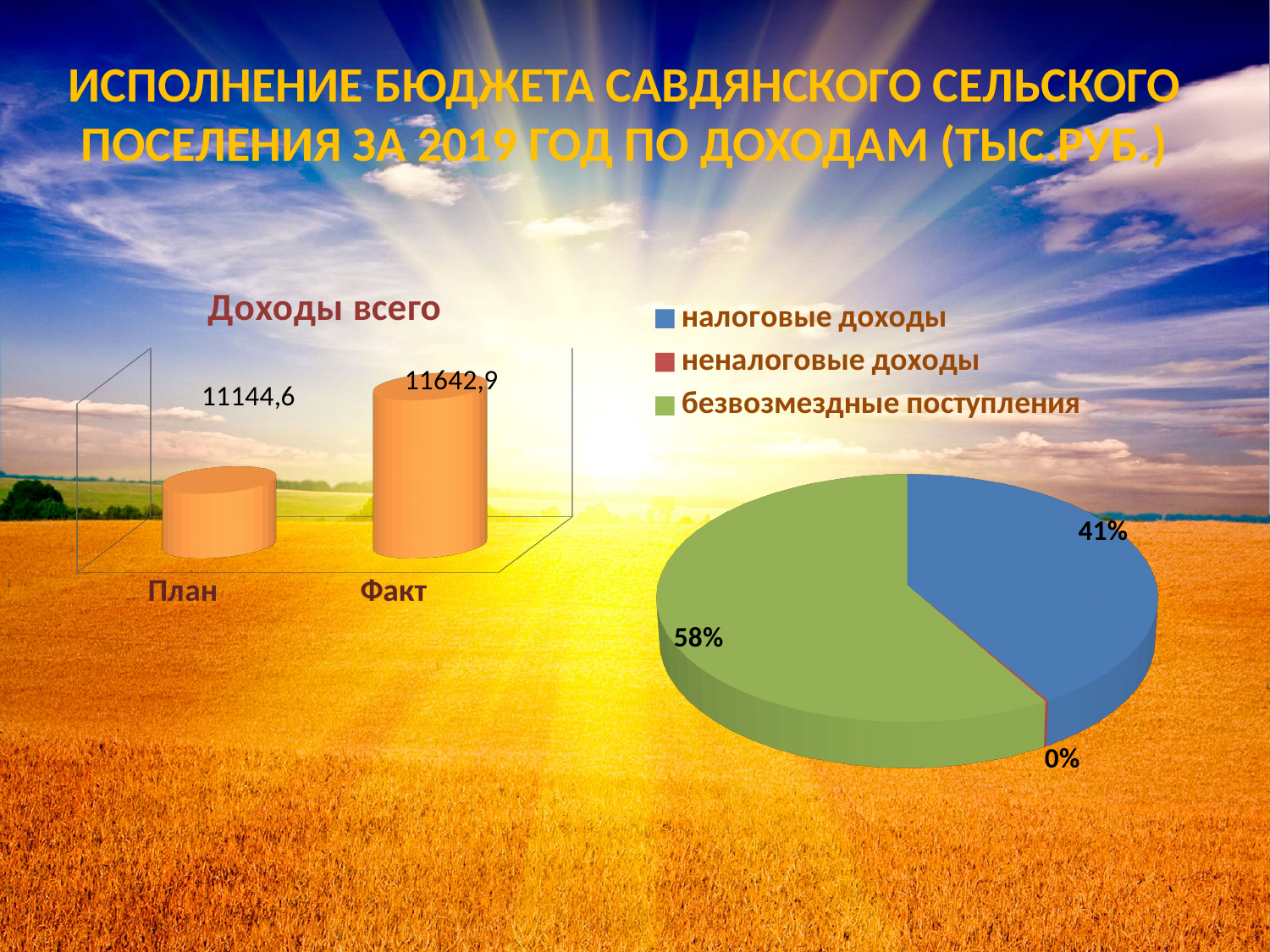
In the 'Доходы всего' chart, what is the value for Факт? 11642,9 In the pie chart on the right, which category has the largest share? безвозмездные поступления In the pie chart on the right, what share is labelled for безвозмездные поступления? 58% In the pie chart on the right, how many entries does the legend list? 3 In the pie chart on the right, what share is labelled for неналоговые доходы? 0% In the pie chart on the right, what colour is the slice for налоговые доходы? Blue In the 'Доходы всего' chart, what is the value for План? 11144,6 In the 'Доходы всего' chart, what is the difference between Факт and План? 498,3 In the pie chart on the right, what share is labelled for налоговые доходы? 41% In the 'Доходы всего' chart, which category has the higher value, План or Факт? Факт What kind of chart is the 'Доходы всего' chart? Bar chart In the 'Доходы всего' chart, how many categories are shown? 2